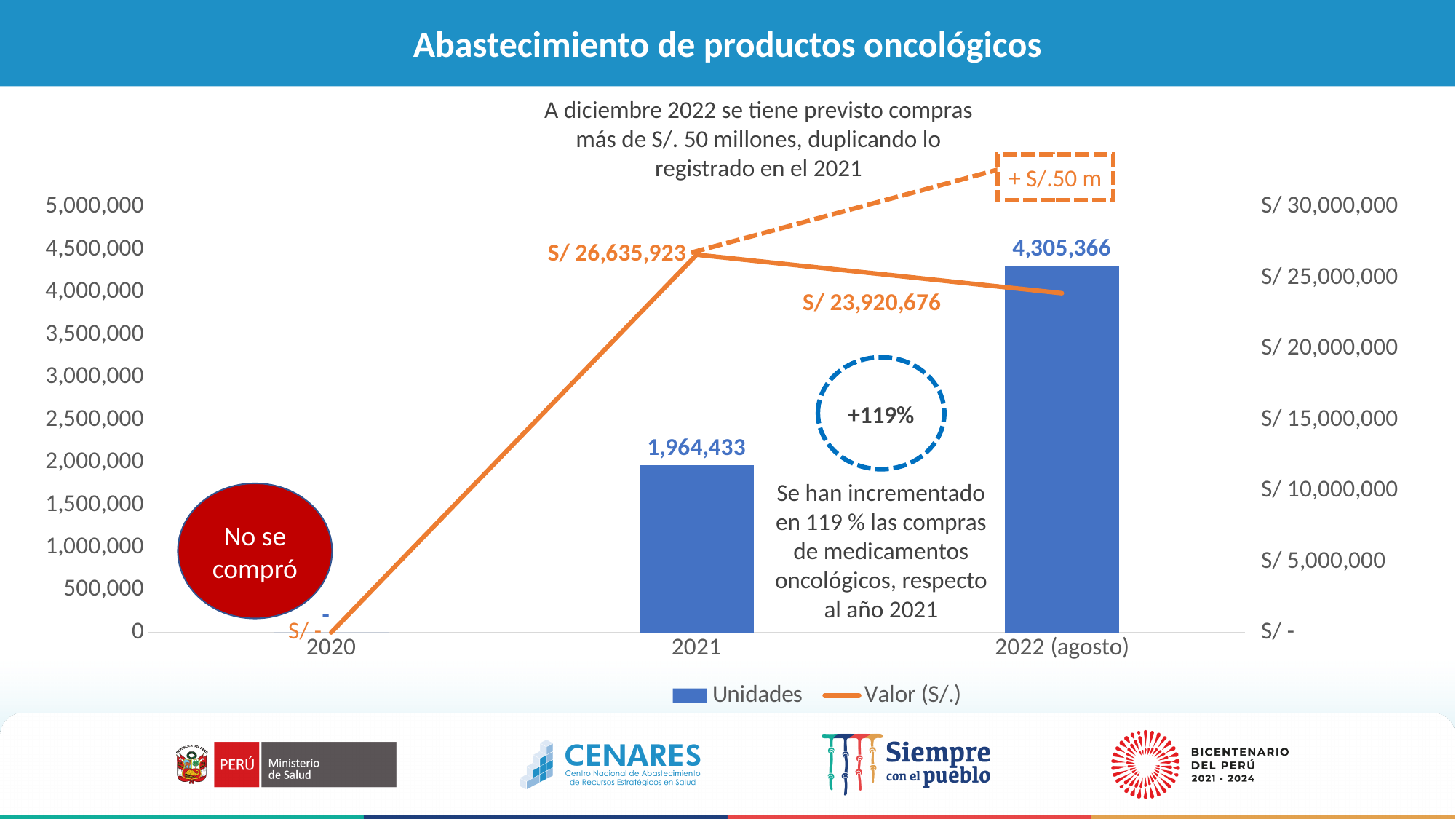
What is the difference in Valor (S/.) between 2021 and 2022 (agosto)? S/ 2,715,247 Which year has the highest Unidades value? 2022 (agosto) What is the value of Unidades for 2022 (agosto)? 4,305,366 What is the value of Unidades for 2021? 1,964,433 Which year has the highest Valor (S/.)? 2021 What is the difference in Unidades between 2022 (agosto) and 2021? 2,340,933 How many series does the legend list? 2 What is the Valor (S/.) for 2022 (agosto)? S/ 23,920,676 What is the title of the chart? Abastecimiento de productos oncológicos What is the Valor (S/.) for 2021? S/ 26,635,923 How many categories are shown on the x axis? 3 Is the Valor (S/.) larger in 2021 or in 2022 (agosto)? 2021